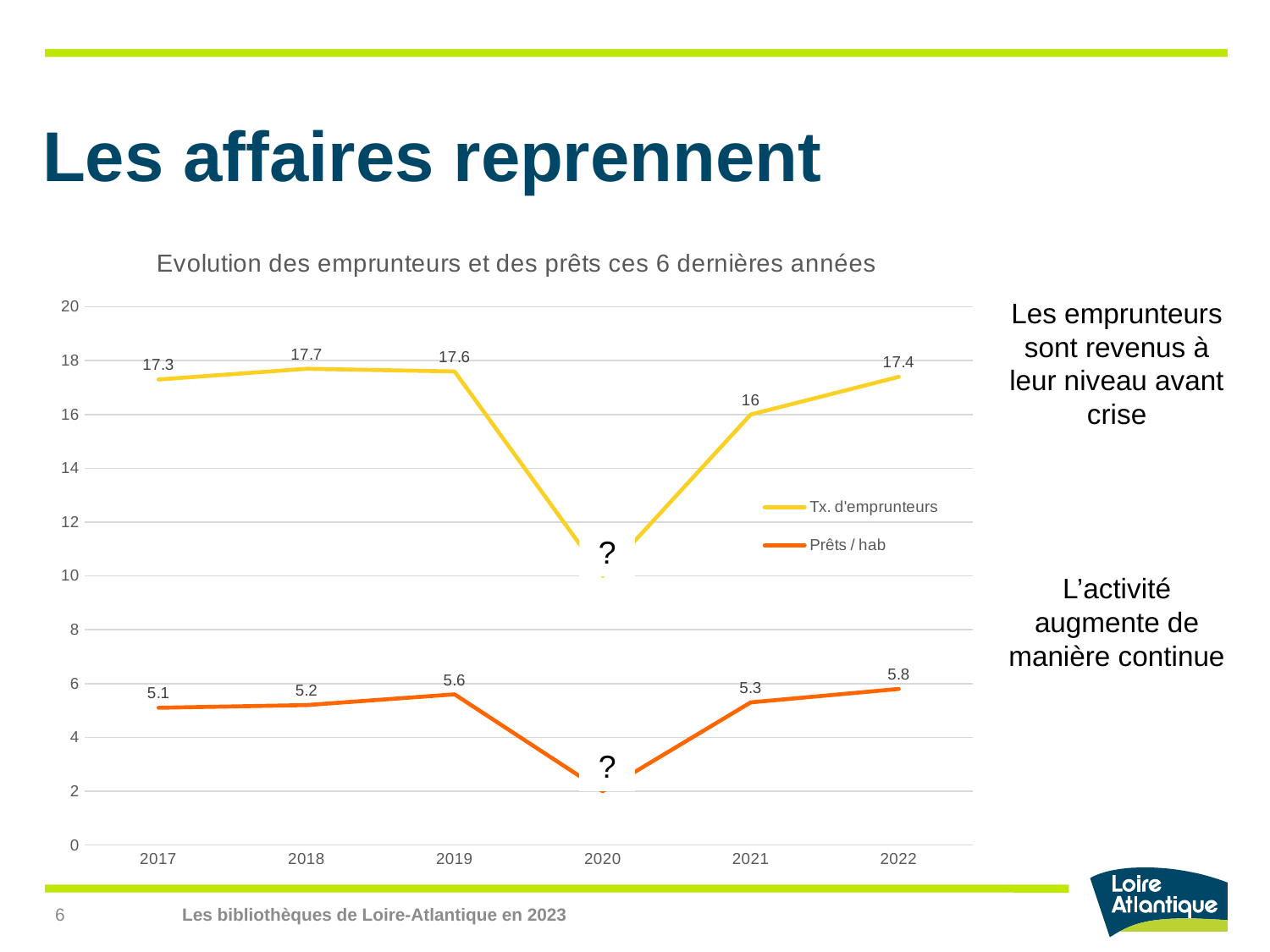
What type of chart is shown on the slide? line chart What is the title of the chart? Evolution des emprunteurs et des prêts ces 6 dernières années What is the value of Prêts / hab in 2022? 5.8 Among the labelled years, which year has the lowest value for Tx. d'emprunteurs? 2021 What is the difference between the Tx. d'emprunteurs values in 2018 and 2021? 1.7 What is the value of Tx. d'emprunteurs in 2018? 17.7 Which is larger, Prêts / hab in 2019 or in 2021? 2019 What label is shown for the 2020 data points on both lines? ? How many years are shown on the x axis? 6 What is the value of Tx. d'emprunteurs in 2021? 16 How many series does the legend list? 2 Among the labelled years, which year has the highest value for Prêts / hab? 2022